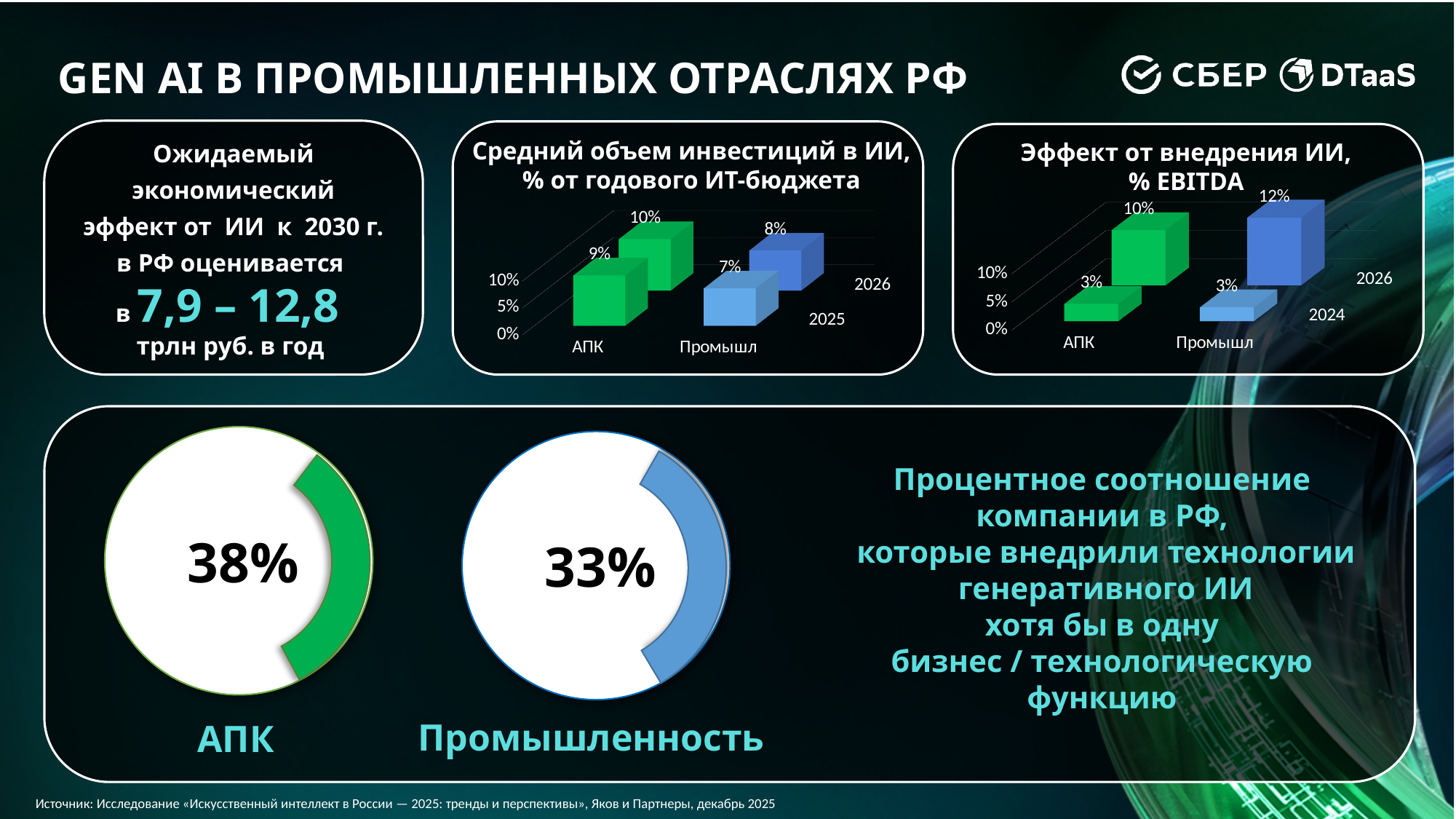
In the chart 'Эффект от внедрения ИИ, % EBITDA', what is the value for АПК in 2024? 3% In the chart 'Средний объем инвестиций в ИИ, % от годового ИТ-бюджета', what is the value for Промышл in 2025? 7% In the donut chart labelled АПК at the bottom of the slide, what percentage is shown? 38% In the chart 'Эффект от внедрения ИИ, % EBITDA', what is the value for Промышл in 2026? 12% In the chart 'Средний объем инвестиций в ИИ, % от годового ИТ-бюджета', which category has the higher value in 2026, АПК or Промышл? АПК What kind of chart is 'Средний объем инвестиций в ИИ, % от годового ИТ-бюджета'? bar chart In the chart 'Эффект от внедрения ИИ, % EBITDA', do the values for АПК rise or fall from 2024 to 2026? rise In the chart 'Эффект от внедрения ИИ, % EBITDA', which category has the highest value in 2026? Промышл In the chart 'Средний объем инвестиций в ИИ, % от годового ИТ-бюджета', what is the value for АПК in 2026? 10% Which of the two donut charts at the bottom of the slide shows the larger share, АПК or Промышленность? АПК In the chart 'Средний объем инвестиций в ИИ, % от годового ИТ-бюджета', what is the difference between the АПК value in 2026 and the АПК value in 2025? 1% In the chart 'Эффект от внедрения ИИ, % EBITDA', what is the difference between the Промышл value in 2026 and in 2024? 9%